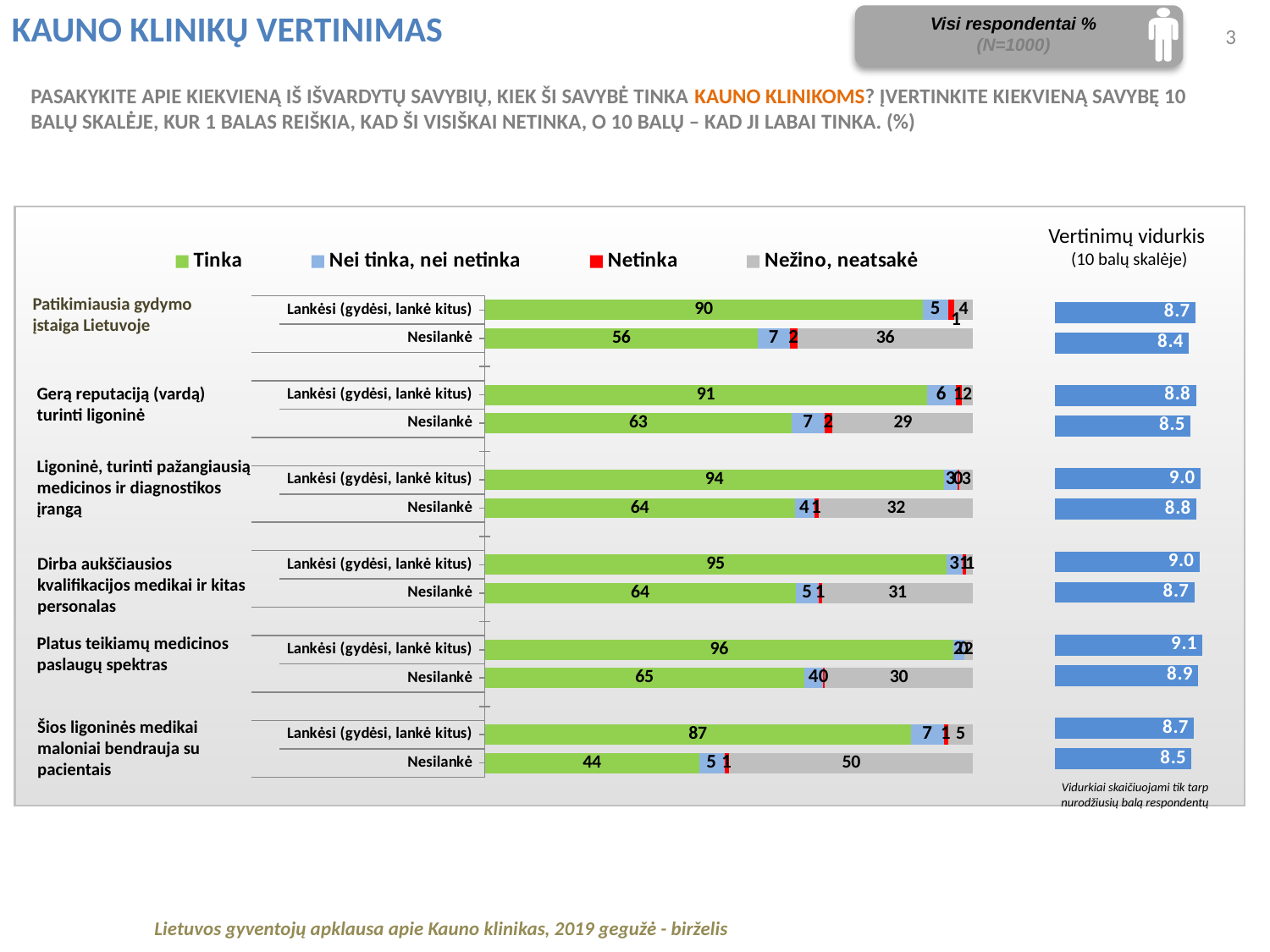
In the stacked bar chart, which attribute has the highest 'Tinka' value among 'Lankėsi (gydėsi, lankė kitus)'? Platus teikiamų medicinos paslaugų spektras In the stacked bar chart, what is the 'Nežino, neatsakė' value for 'Šios ligoninės medikai maloniai bendrauja su pacientais' among 'Nesilankė'? 50 How many attributes (row groups) are evaluated in the stacked bar chart? 6 In the stacked bar chart, which attribute has the lowest 'Tinka' value among 'Nesilankė'? Šios ligoninės medikai maloniai bendrauja su pacientais What kind of chart is the main chart on the slide? Stacked bar chart In the stacked bar chart, what is the difference between the 'Tinka' values for 'Lankėsi (gydėsi, lankė kitus)' and 'Nesilankė' for 'Patikimiausia gydymo įstaiga Lietuvoje'? 34 In the stacked bar chart, among 'Nesilankė', which has the larger 'Nežino, neatsakė' value: 'Patikimiausia gydymo įstaiga Lietuvoje' or 'Gerą reputaciją (vardą) turinti ligoninė'? Patikimiausia gydymo įstaiga Lietuvoje In the 'Vertinimų vidurkis' chart, what is the average score for 'Platus teikiamų medicinos paslaugų spektras' among 'Lankėsi (gydėsi, lankė kitus)'? 9.1 In the stacked bar chart, what is the 'Nei tinka, nei netinka' value for 'Šios ligoninės medikai maloniai bendrauja su pacientais' among 'Lankėsi (gydėsi, lankė kitus)'? 7 In the stacked bar chart, what is the 'Tinka' value for 'Platus teikiamų medicinos paslaugų spektras' among 'Lankėsi (gydėsi, lankė kitus)'? 96 In the 'Vertinimų vidurkis' chart, what is the average score for 'Patikimiausia gydymo įstaiga Lietuvoje' among 'Nesilankė'? 8.4 How many series does the legend of the stacked bar chart list? 4